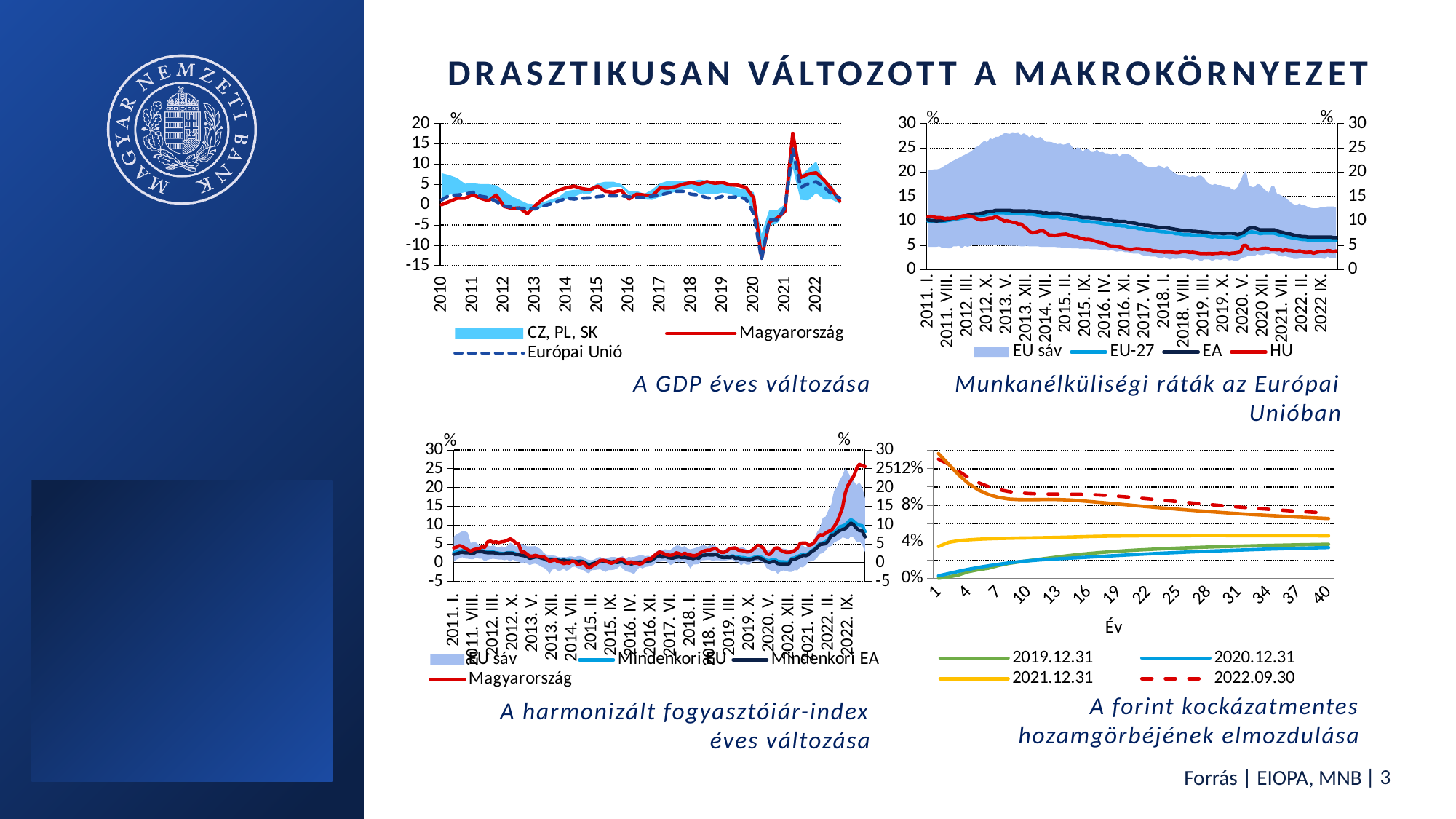
In "A forint kockázatmentes hozamgörbéjének elmozdulása", does the 2022.09.30 curve rise or fall as the year increases? fall How many series does the legend of "Munkanélküliségi ráták az Európai Unióban" list? 4 In "A GDP éves változása", is the lowest value of Magyarország in 2020 greater or less than -10? less In "A forint kockázatmentes hozamgörbéjének elmozdulása", is the 2019.12.31 value at year 1 greater or less than 4%? less What is the x-axis label of "A forint kockázatmentes hozamgörbéjének elmozdulása"? Év In "Munkanélküliségi ráták az Európai Unióban", which is higher at 2022. IX., EA or HU? EA In "A GDP éves változása", is the peak value of Magyarország in 2021 greater or less than 15? greater How many series does the legend of "A GDP éves változása" list? 3 In "A harmonizált fogyasztóiár-index éves változása", which is higher at 2022. IX., Magyarország or Mindenkori EU? Magyarország What kind of chart is "A forint kockázatmentes hozamgörbéjének elmozdulása"? line chart